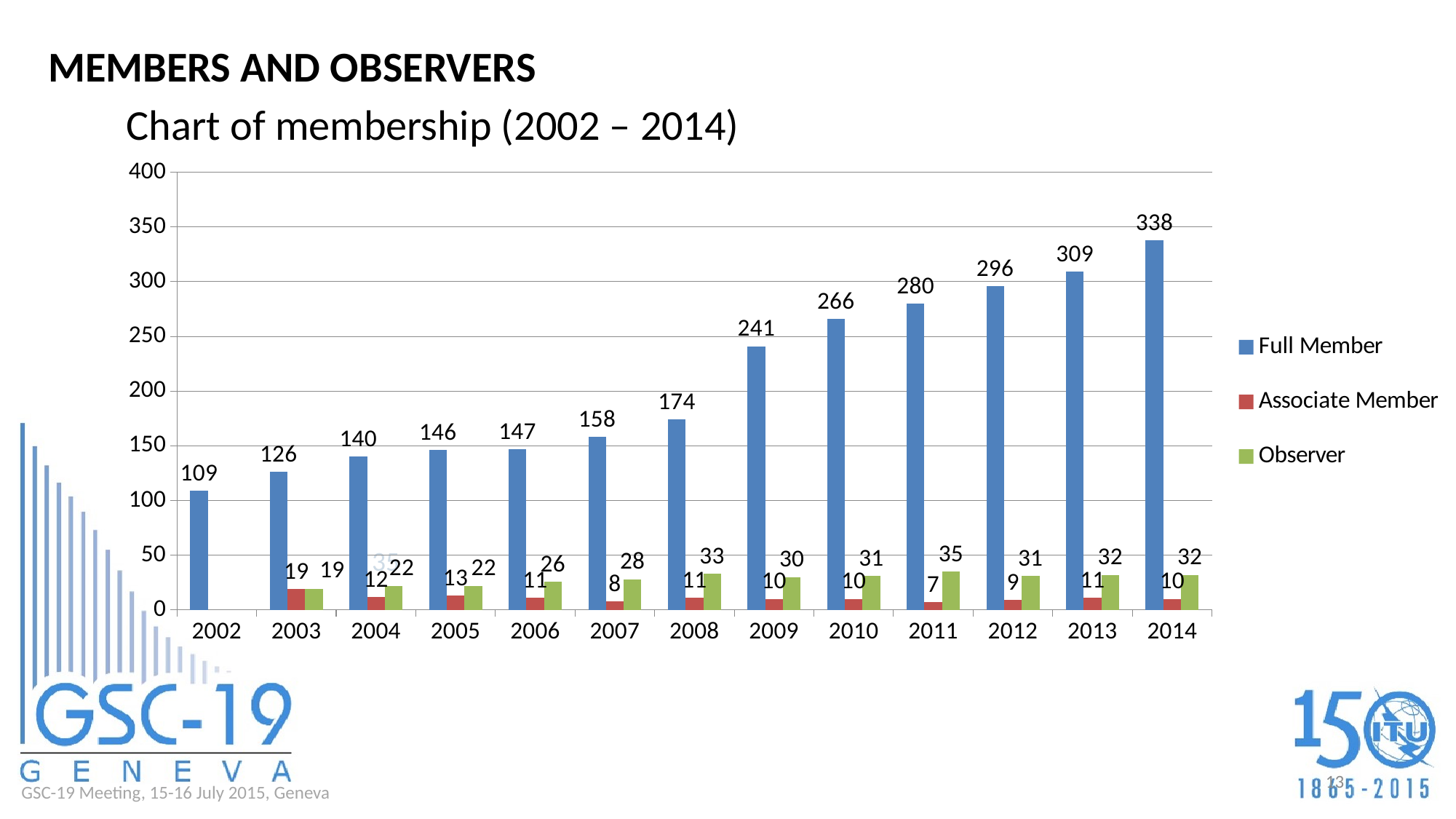
Do the Full Member values rise or fall from 2002 to 2014? Rise Which year has the lowest Full Member value? 2002 How many series does the legend list? 3 Which year has the highest Full Member value? 2014 What is the Observer value for 2011? 35 What is the difference between the Full Member values for 2014 and 2013? 29 What is the Full Member value for 2014? 338 What is the Associate Member value for 2007? 8 Which is larger, the Observer value for 2008 or the Observer value for 2009? 2008 What is the difference between the Full Member values for 2009 and 2008? 67 What kind of chart is shown on the slide? Bar chart How many years are shown on the x axis? 13